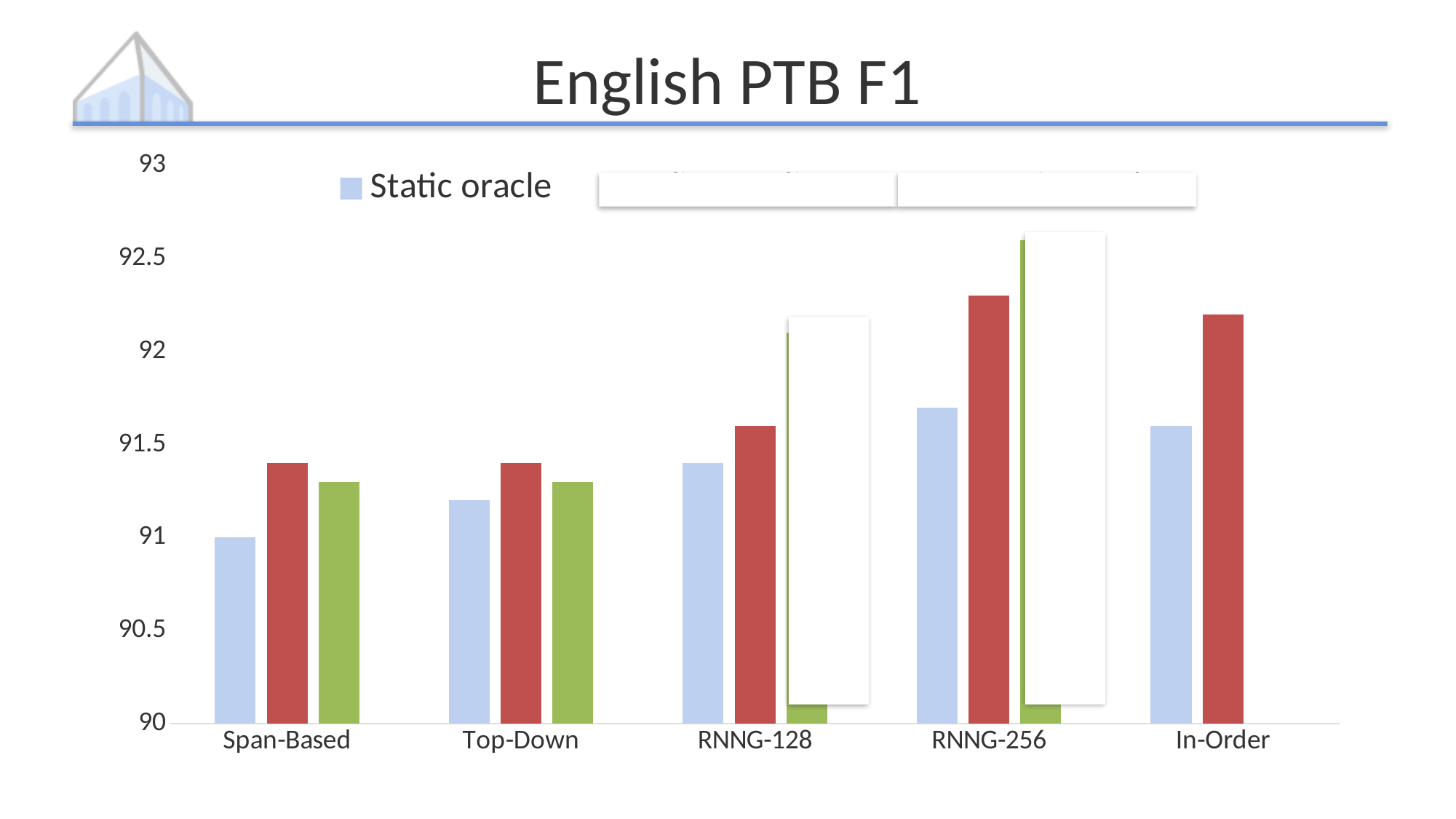
Which category has the lowest Static oracle value? Span-Based Which series name is readable in the chart legend? Static oracle Is the Static oracle value for Top-Down greater or less than 91.5? less Is the red bar for Span-Based greater or less than 91.5? less Which has the larger Static oracle value, Span-Based or Top-Down? Top-Down Is the red bar for RNNG-256 greater or less than 92? greater Which category has the highest Static oracle value? RNNG-256 For In-Order, which is larger, the Static oracle bar or the red bar? the red bar What is the title of the chart? English PTB F1 How many categories are shown on the x axis? 5 What kind of chart is shown on the slide? bar chart